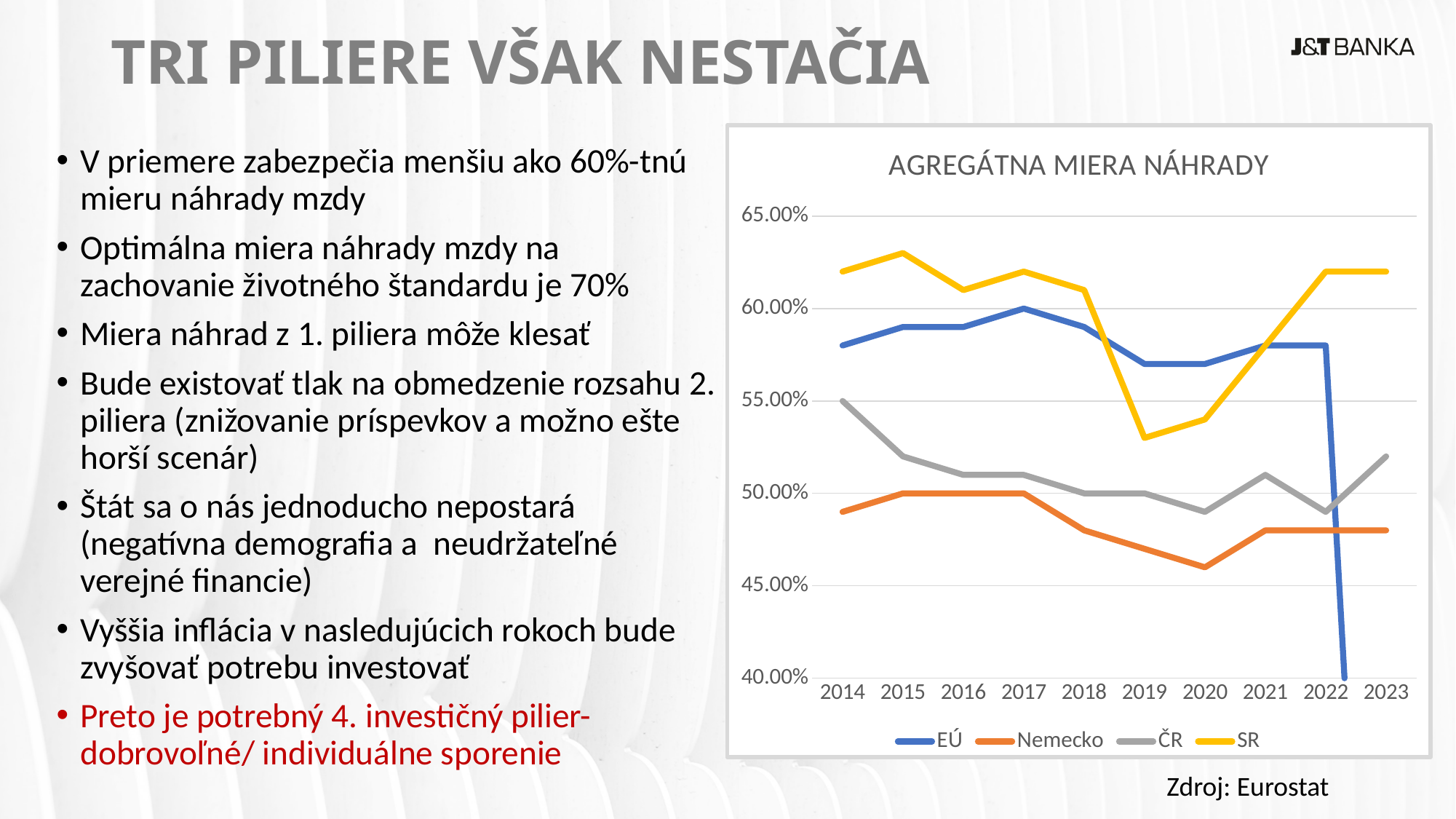
Which series has the lowest value in 2014? Nemecko Which series has the highest value in 2014? SR What kind of chart is shown on the slide? line chart How many years are shown on the x axis of the chart? 10 Does the value for Nemecko rise or fall from 2017 to 2020? fall Is the value for EÚ in 2014 greater or less than 55.00%? greater What is the title of the chart? AGREGÁTNA MIERA NÁHRADY How many series does the chart legend list? 4 Is the value for SR in 2015 greater or less than 60.00%? greater Which is larger in 2018, the value for SR or the value for EÚ? SR Is the value for SR in 2019 greater or less than 55.00%? less